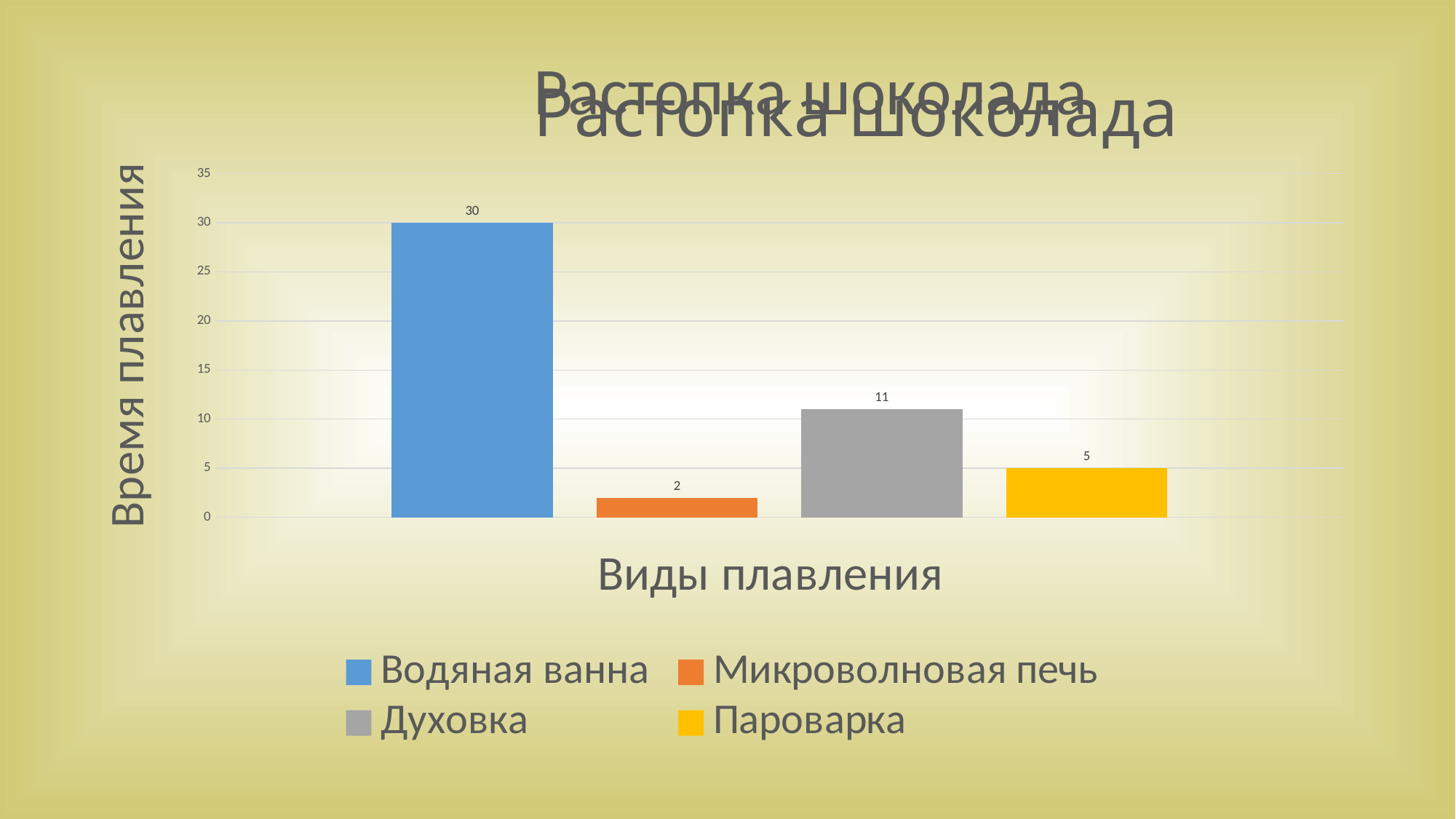
How many bars are plotted in the chart? 4 What is the title of the chart? Растопка шоколада Which is larger, the value for Духовка or the value for Пароварка? Духовка Which category has the highest value? Водяная ванна What is the value for Водяная ванна? 30 Which category has the lowest value? Микроволновая печь What is the value for Пароварка? 5 What is the difference between the values for Водяная ванна and Духовка? 19 What is the value for Духовка? 11 Is the value for Духовка greater or less than 10? greater What kind of chart is shown on the slide? Bar chart What is the value for Микроволновая печь? 2